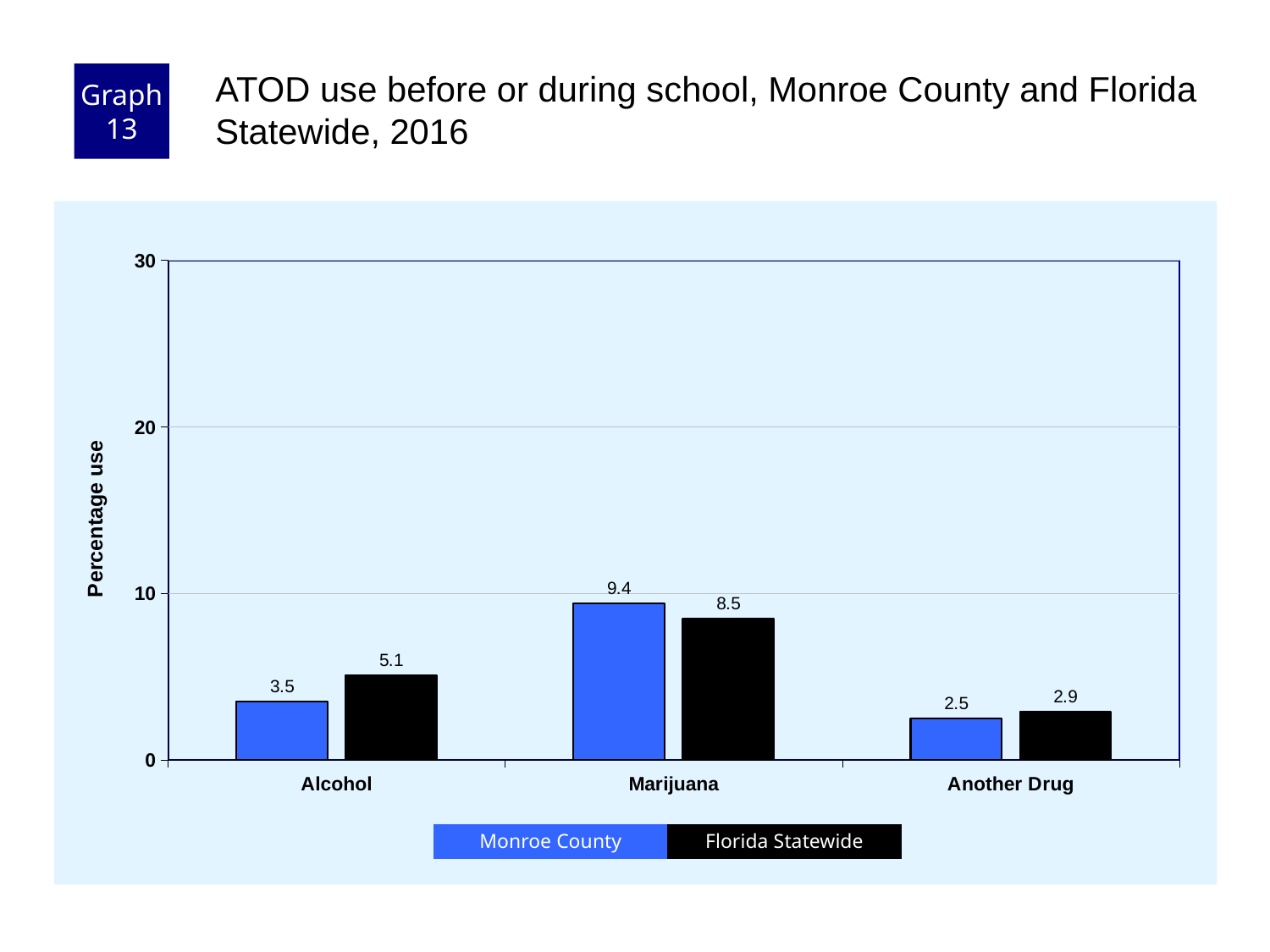
How many series does the legend list? 2 What kind of chart is shown? bar chart What is the Monroe County value for Another Drug? 2.5 What is the Florida Statewide value for Alcohol? 5.1 What is the label of the y axis? Percentage use Which category has the highest Monroe County value? Marijuana Which is larger for Marijuana, Monroe County or Florida Statewide? Monroe County What is the Monroe County value for Marijuana? 9.4 How many categories are shown on the x axis? 3 Which category has the lowest Florida Statewide value? Another Drug Is the Florida Statewide value for Marijuana greater or less than 10? less What is the difference between the Florida Statewide and Monroe County values for Alcohol? 1.6